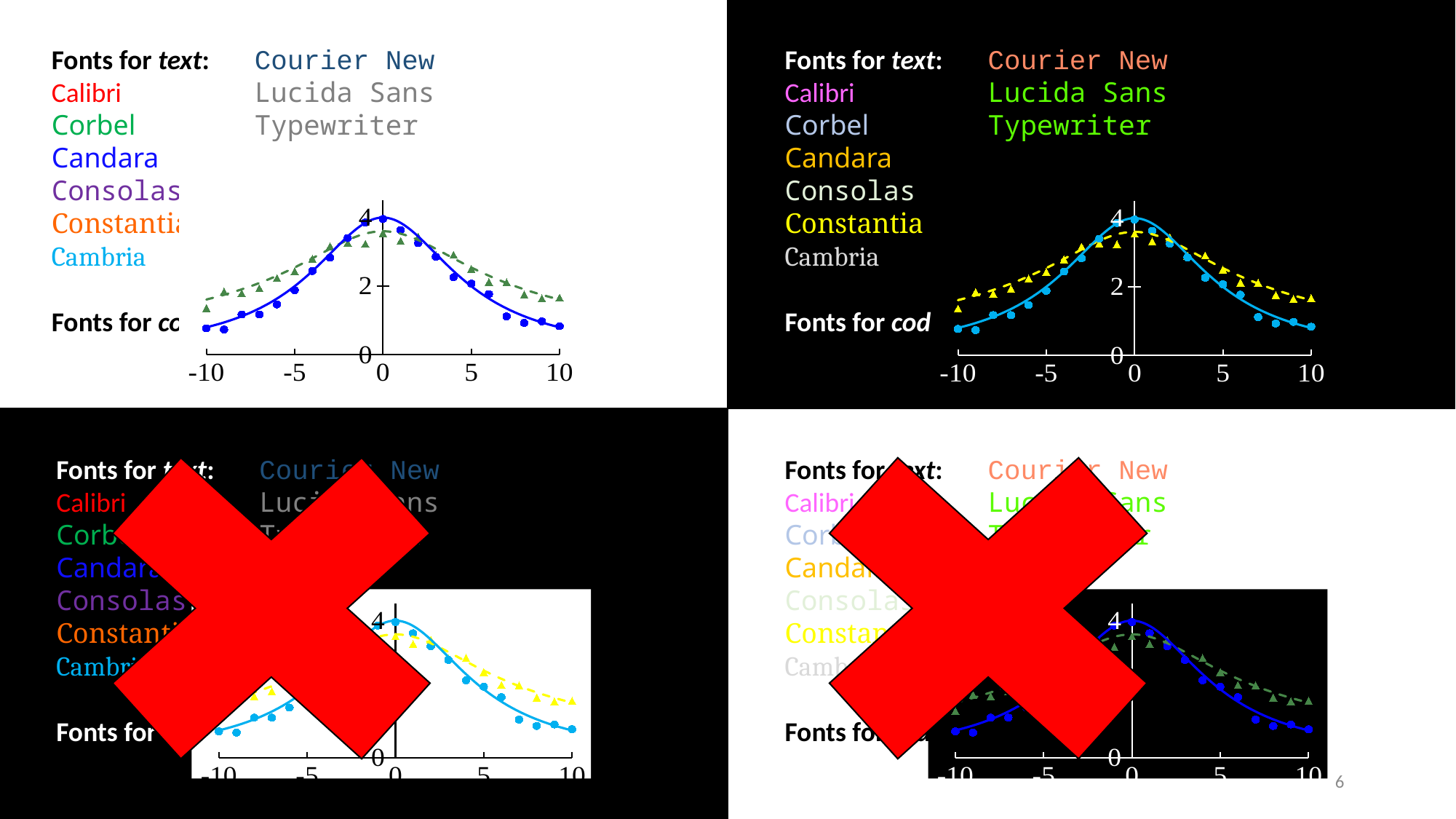
In the top-left chart, at x = 0, which series has the larger value: the solid blue series or the dashed green series? the solid blue series In the top-left chart, what is the highest tick label on the y axis? 4 In the top-right chart, at x = 10, which series has the larger value: the solid blue series or the dashed yellow series? the dashed yellow series In the top-left chart, how many data series are plotted? 4 How many charts are shown on the slide? 4 In the top-right chart, is the value of the solid blue series at x = -10 greater or less than 2? less What kind of chart is shown in the top-left panel of the slide? line chart In the top-left chart, is the value of the solid blue series at x = 10 greater or less than 2? less In the top-left chart, is the value of the dashed green series at x = 0 greater or less than 2? greater In the top-left chart, how many tick labels are shown on the x axis? 5 In the top-left chart, do the values of the solid blue series rise or fall as x goes from 0 to 10? fall